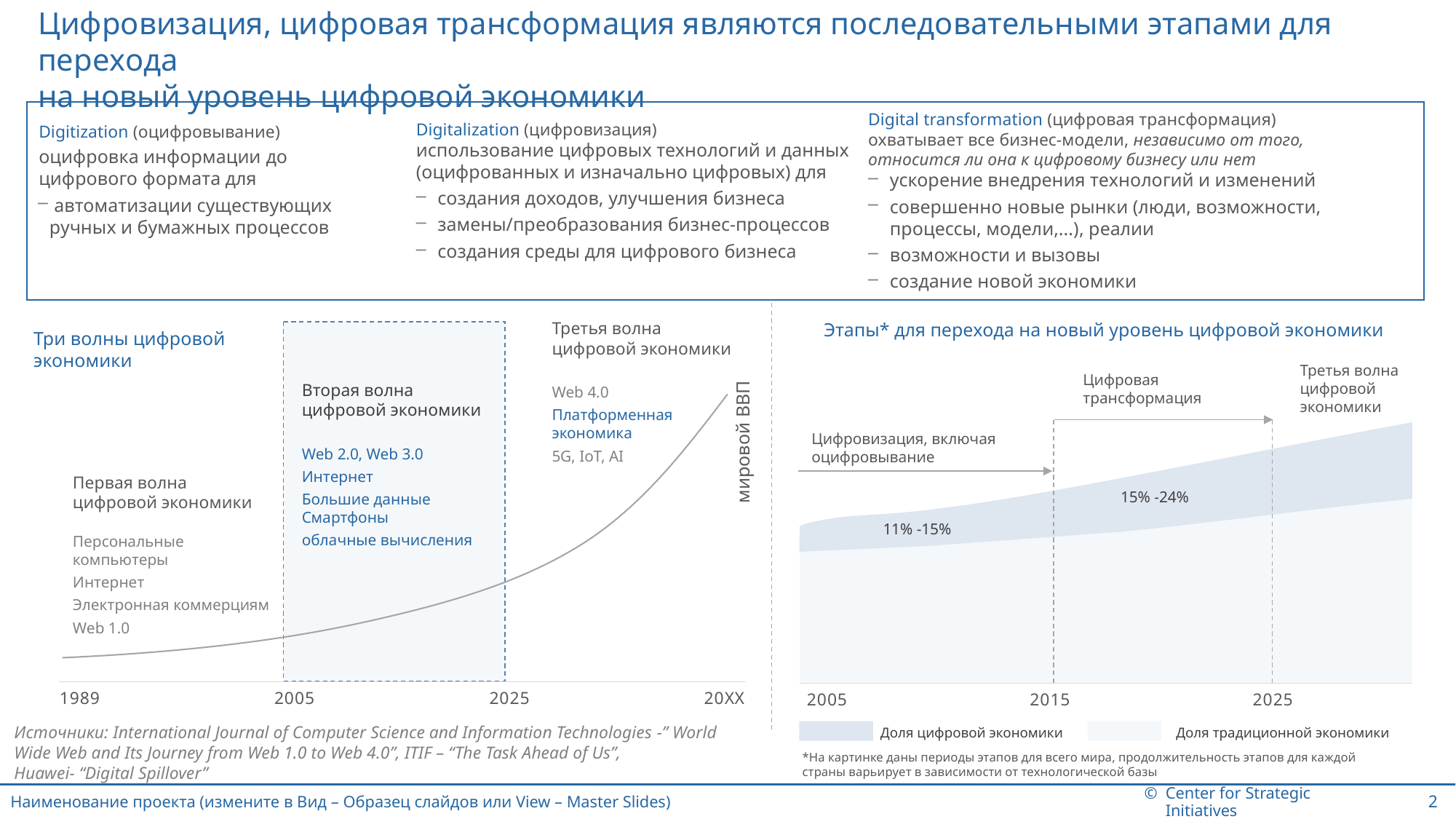
On the left chart 'Три волны цифровой экономики', how many year labels are shown on the x axis? 4 On the right chart 'Этапы* для перехода на новый уровень цифровой экономики', which period has the larger labelled share of the digital economy: 2005–2015 or 2015–2025? 2015–2025 On the right chart 'Этапы* для перехода на новый уровень цифровой экономики', does the share of the digital economy rise or fall from 2005 to 2025? rise On the right chart 'Этапы* для перехода на новый уровень цифровой экономики', how many year labels are shown on the x axis? 3 On the right chart 'Этапы* для перехода на новый уровень цифровой экономики', what share of the digital economy is labelled for the period between 2005 and 2015? 11% -15% On the right chart 'Этапы* для перехода на новый уровень цифровой экономики', what share of the digital economy is labelled for the period between 2015 and 2025? 15% -24% On the left chart 'Три волны цифровой экономики', what is the label of the vertical axis? мировой ВВП On the left chart 'Три волны цифровой экономики', which year label is the first on the x axis? 1989 On the left chart 'Три волны цифровой экономики', does the curve rise or fall from 1989 to 20XX? rise On the right chart 'Этапы* для перехода на новый уровень цифровой экономики', what kind of chart is it? area chart On the right chart 'Этапы* для перехода на новый уровень цифровой экономики', how many series does the legend list? 2 On the left chart 'Три волны цифровой экономики', what kind of chart is it? line chart